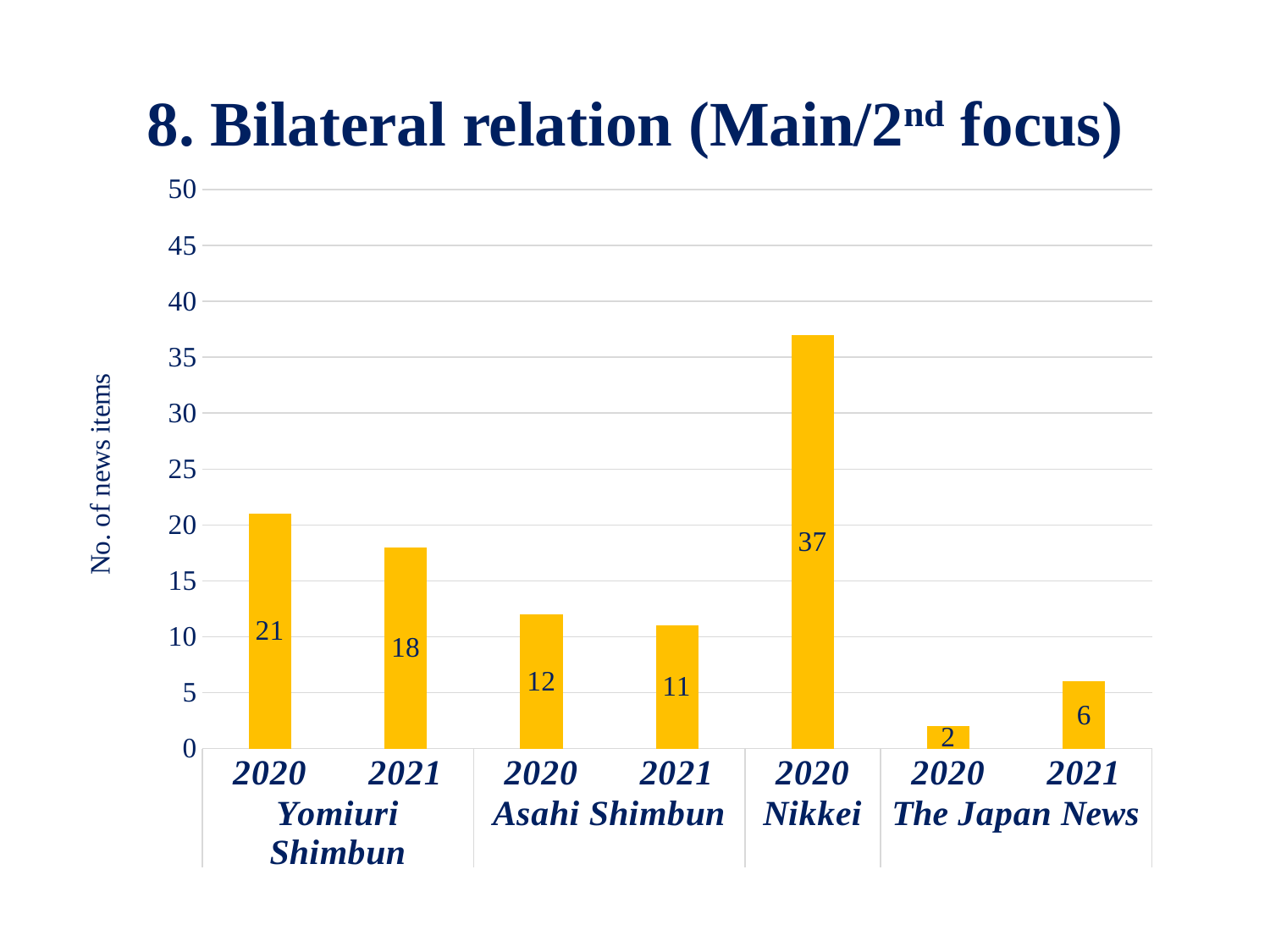
What is the value for The Japan News in 2021? 6 What is the difference between Yomiuri Shimbun's 2020 and 2021 values? 3 What is the value for Yomiuri Shimbun in 2020? 21 How many bars are plotted in the chart? 7 What kind of chart is shown on the slide? Bar chart Which is larger: Asahi Shimbun 2020 or The Japan News 2021? Asahi Shimbun 2020 What is the label of the vertical axis? No. of news items Is the value for Nikkei 2020 greater or less than 35? greater What is the value for Asahi Shimbun in 2021? 11 What is the value for Nikkei in 2020? 37 Which bar has the lowest value? The Japan News 2020 Which bar has the highest value? Nikkei 2020